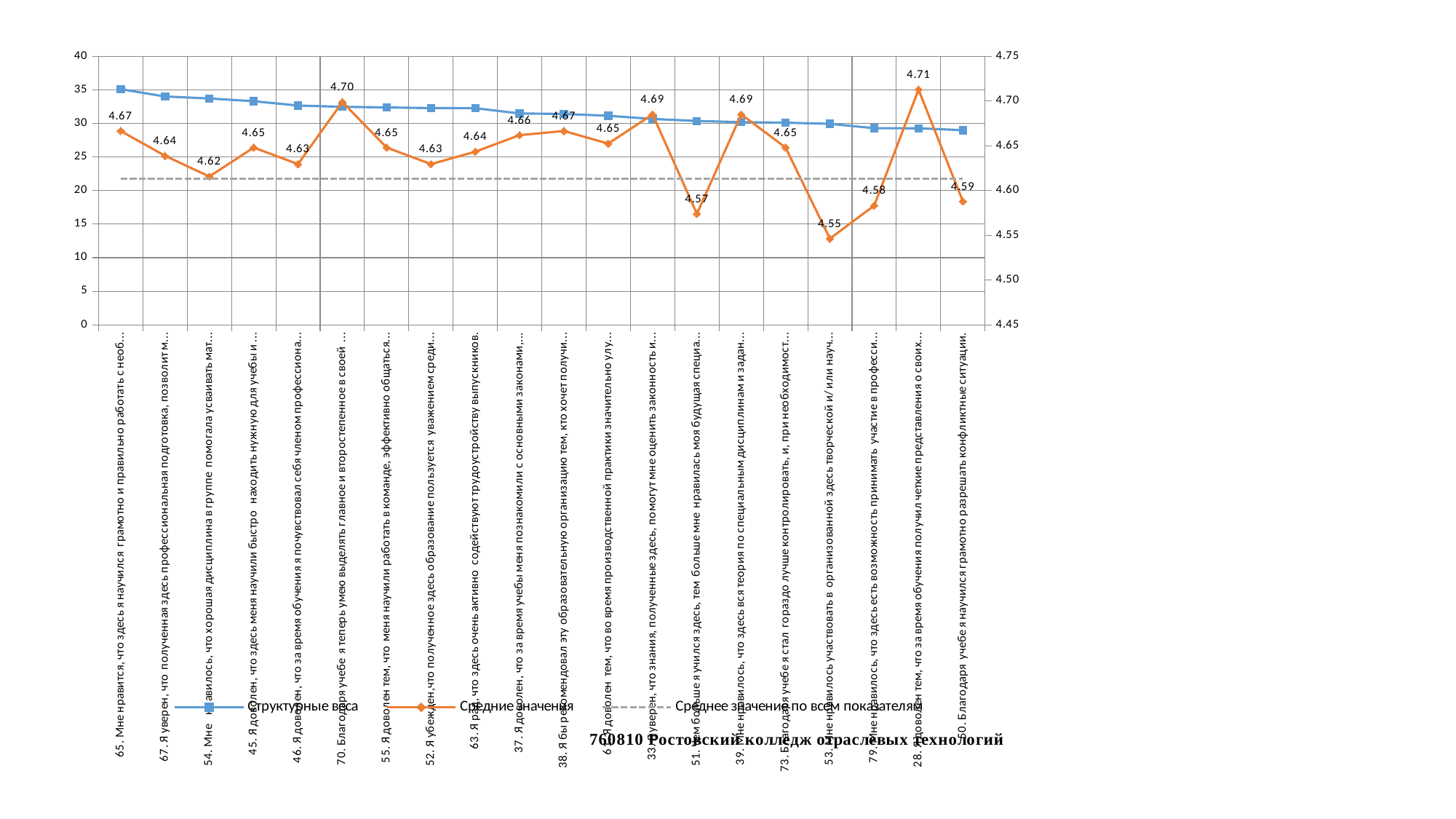
Do the values of the Структурные веса series rise or fall from left to right along the x axis? fall What is the title shown on the chart? 760810 Ростовский колледж отраслевых технологий Which has a larger Средние значения value: the category beginning "33. Я уверен, что знания, полученные здесь" or the category beginning "51. Чем больше я учился здесь"? 33. Я уверен, что знания, полученные здесь How many series does the legend list? 3 What is the Средние значения value for the category beginning "70. Благодаря учебе я теперь умею выделять главное и второстепенное"? 4.70 What is the Средние значения value for the category beginning "51. Чем больше я учился здесь, тем больше мне нравилась моя будущая специа..."? 4.57 What is the highest value of the Средние значения series? 4.71 How many categories are plotted along the x axis? 20 What kind of chart is shown on the slide? line chart Is the Структурные веса value for the first category (beginning "65. Мне нравится") greater or less than 30? greater What is the difference between the highest and lowest values of the Средние значения series? 0.16 What is the lowest value of the Средние значения series? 4.55